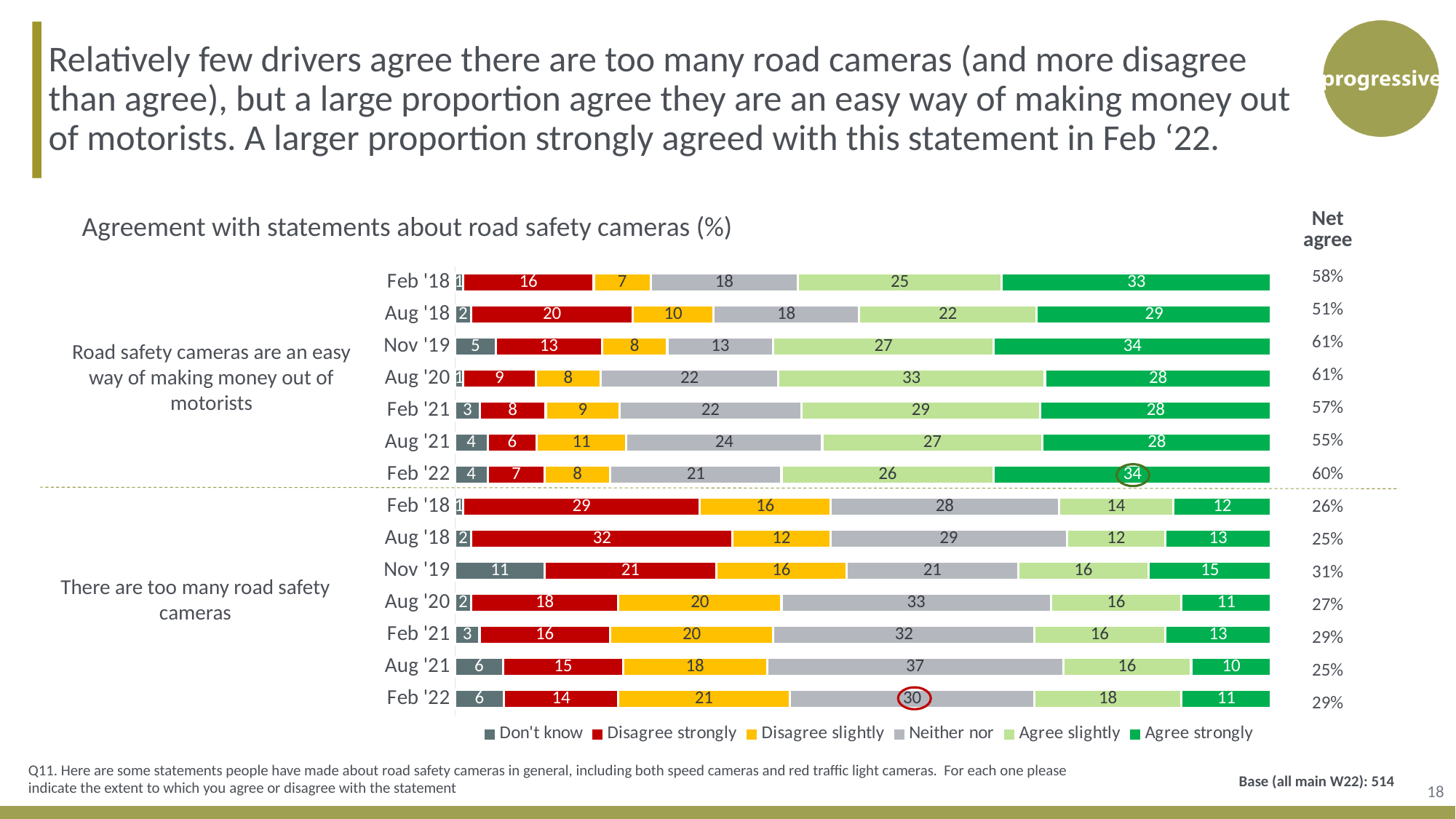
What percentage of drivers 'Agree strongly' that road safety cameras are an easy way of making money out of motorists in Feb '22? 34 What is the 'Neither nor' value for 'There are too many road safety cameras' in Feb '22? 30 For 'Road safety cameras are an easy way of making money out of motorists', how much higher is the 'Agree strongly' value in Feb '22 than in Aug '21? 6 What is the total of the Feb '22 bar for 'There are too many road safety cameras'? 100 What is the Net agree figure for 'Road safety cameras are an easy way of making money out of motorists' in Nov '19? 61% For 'There are too many road safety cameras', which wave has the lowest 'Agree strongly' value? Aug '21 What is the title of the chart? Agreement with statements about road safety cameras (%) How many survey waves are shown for each statement? 7 For 'There are too many road safety cameras', which wave has the highest 'Disagree strongly' value? Aug '18 How many series does the legend list? 6 What kind of chart is shown on the slide? Stacked bar chart For 'There are too many road safety cameras', is the 'Disagree strongly' value larger in Feb '18 or Aug '18? Aug '18